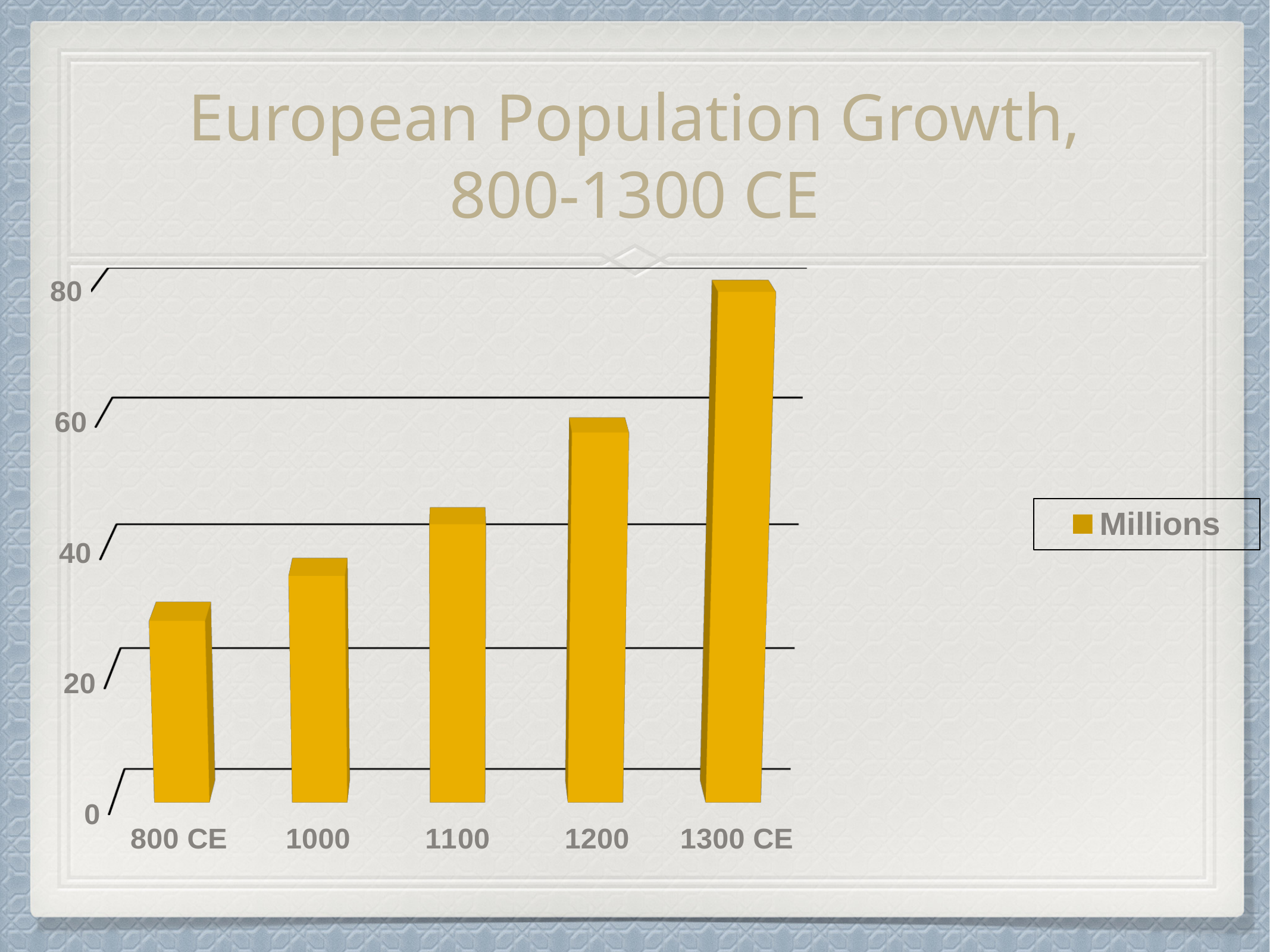
Which is larger, the value for 1200 or the value for 1000? 1200 What kind of chart is shown on the slide? bar chart Do the values rise or fall from 800 CE to 1300 CE? rise Which category has the lowest value? 800 CE Is the value for 1100 greater or less than 40? greater Which category has the highest value? 1300 CE What is the title of the chart on the slide? European Population Growth, 800-1300 CE How many categories are shown on the x axis? 5 Is the value for 1300 CE greater or less than 60? greater What is the name of the series shown in the legend? Millions How many series does the legend list? 1 Is the value for 800 CE greater or less than 40? less